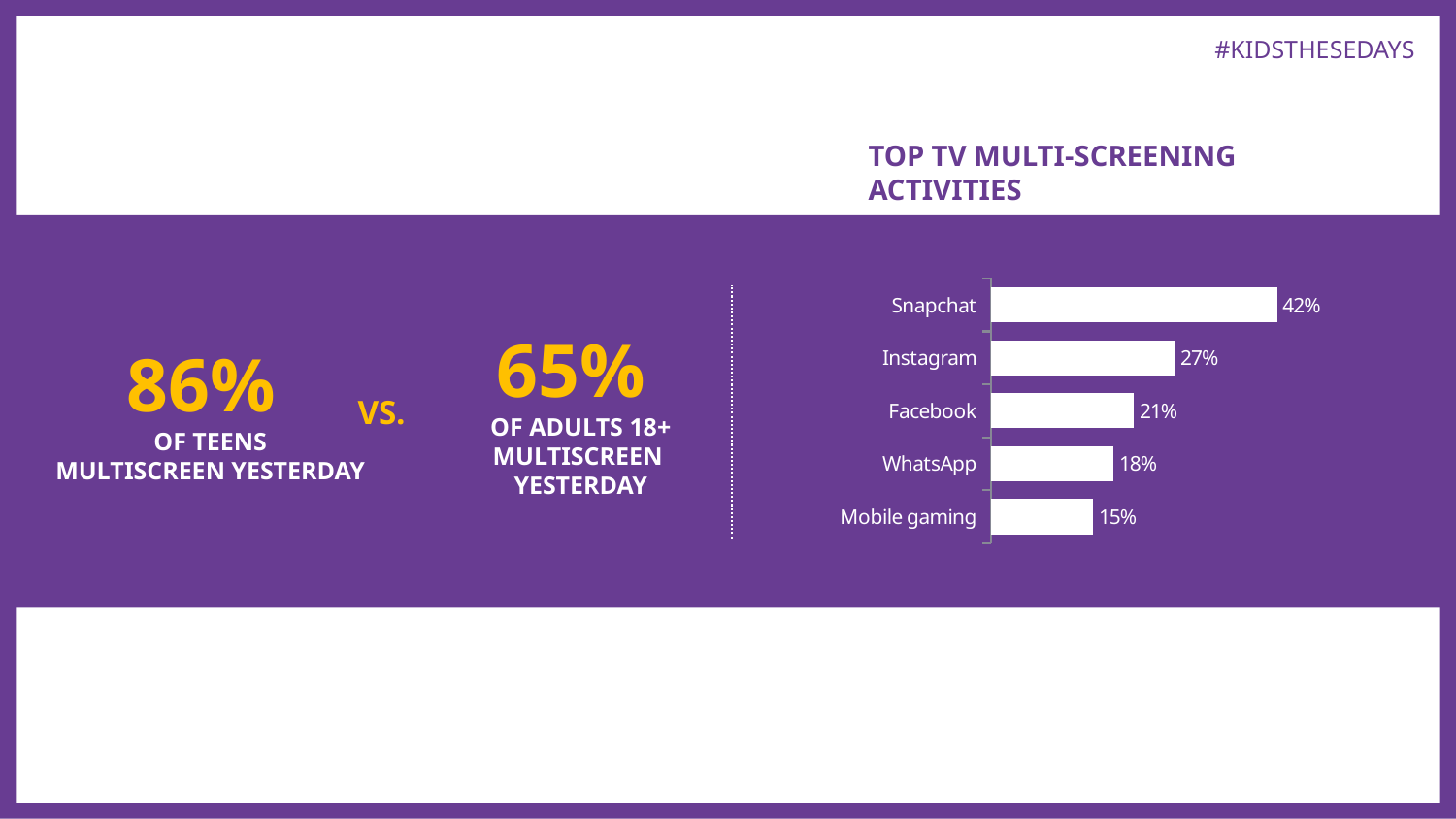
What is the value for Mobile gaming in the Top TV Multi-Screening Activities chart? 15% What kind of chart is the Top TV Multi-Screening Activities chart? Bar chart Which activity has the lowest value in the Top TV Multi-Screening Activities chart? Mobile gaming What is the value for WhatsApp in the Top TV Multi-Screening Activities chart? 18% In the Top TV Multi-Screening Activities chart, which is larger, Facebook or WhatsApp? Facebook Which activity has the highest value in the Top TV Multi-Screening Activities chart? Snapchat What is the difference between the Snapchat and Instagram values in the Top TV Multi-Screening Activities chart? 15% What is the value for Instagram in the Top TV Multi-Screening Activities chart? 27% What is the value for Snapchat in the Top TV Multi-Screening Activities chart? 42% How many activities are shown in the Top TV Multi-Screening Activities chart? 5 What is the title of the chart on the slide? Top TV Multi-Screening Activities What is the difference between the Facebook and WhatsApp values in the Top TV Multi-Screening Activities chart? 3%